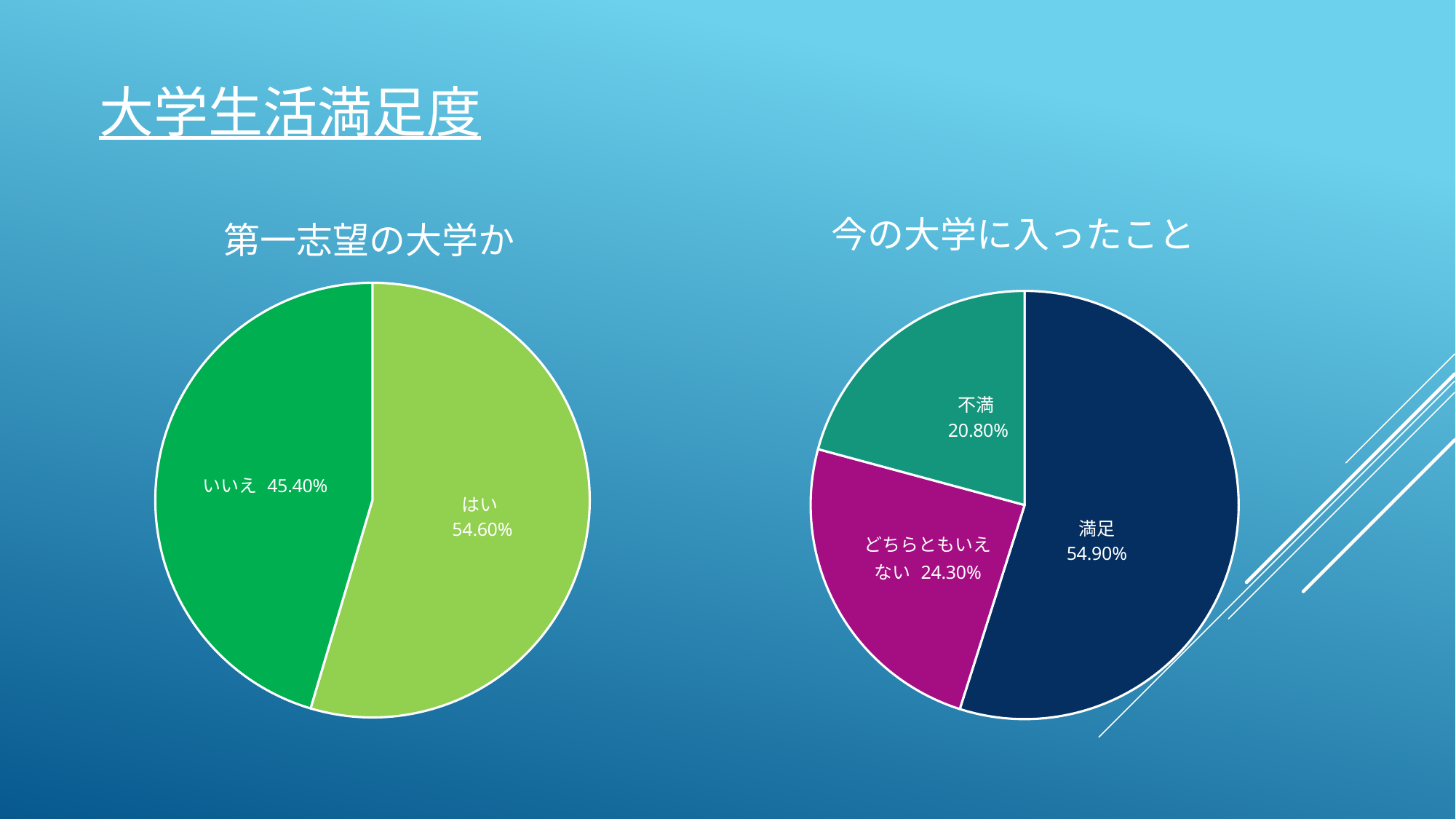
In the left chart titled 第一志望の大学か, how many slices does the pie have? 2 In the left chart titled 第一志望の大学か, what is the difference between はい and いいえ? 9.20% What kind of chart is the left chart titled 第一志望の大学か? Pie chart In the right chart titled 今の大学に入ったこと, what is the value for どちらともいえない? 24.30% In the right chart titled 今の大学に入ったこと, which is larger, どちらともいえない or 不満? どちらともいえない In the right chart titled 今の大学に入ったこと, what is the value for 満足? 54.90% In the right chart titled 今の大学に入ったこと, which slice is the smallest? 不満 In the left chart titled 第一志望の大学か, what is the value for いいえ? 45.40% In the right chart titled 今の大学に入ったこと, what is the value for 不満? 20.80% In the left chart titled 第一志望の大学か, what is the value for はい? 54.60% In the left chart titled 第一志望の大学か, which slice is the largest? はい In the right chart titled 今の大学に入ったこと, how many slices does the pie have? 3